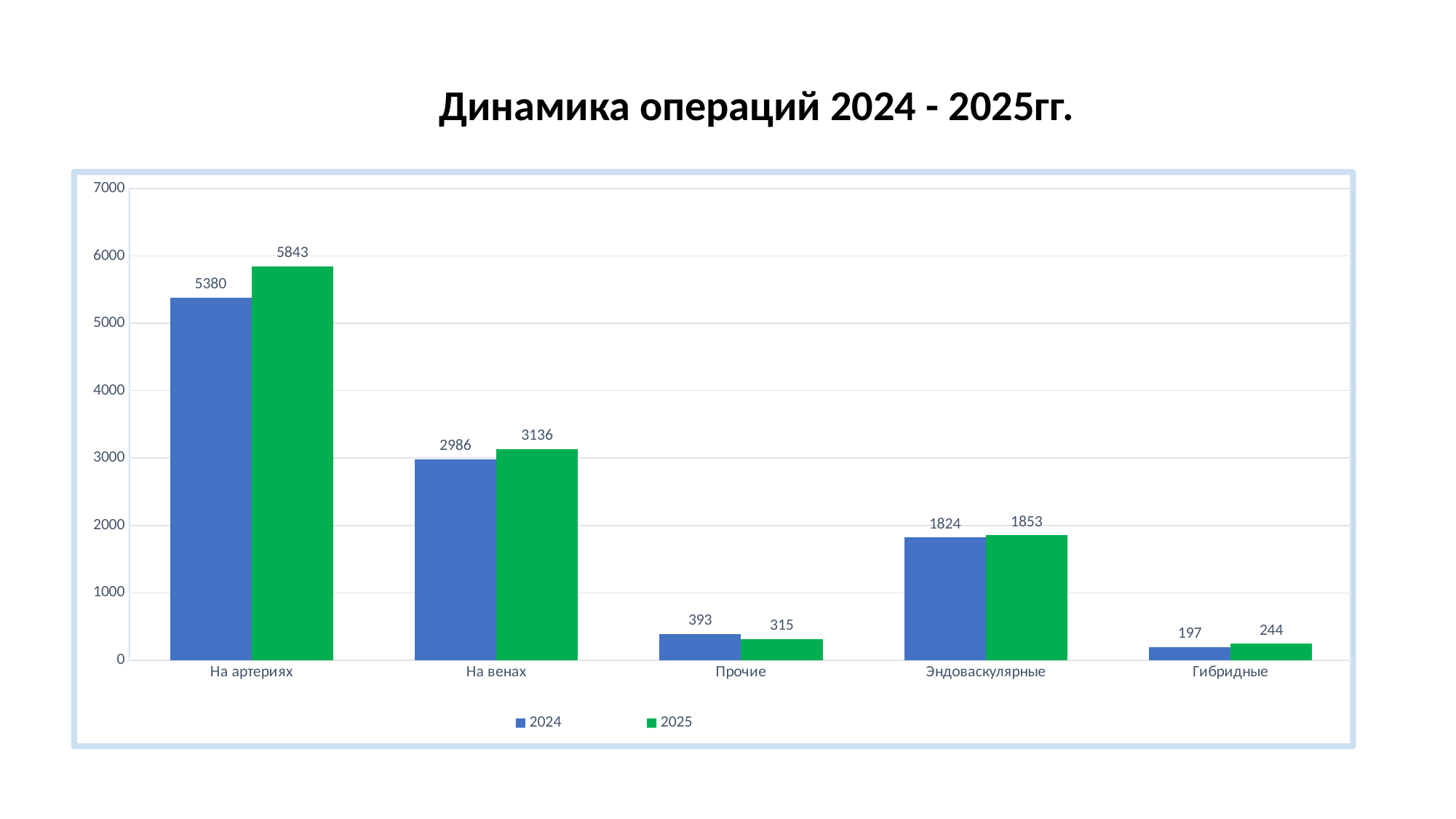
How many series does the legend list? 2 Which category has the highest 2025 value? На артериях What is the 2024 value for На артериях? 5380 For Прочие, which year has the larger value, 2024 or 2025? 2024 What is the 2025 value for Гибридные? 244 What is the title of the chart? Динамика операций 2024 - 2025гг. How many categories are shown on the x axis? 5 What kind of chart is shown on the slide? bar chart Is the 2024 value for На венах greater or less than 3000? less What is the 2025 value for Эндоваскулярные? 1853 Which category has the lowest 2024 value? Гибридные What is the difference between the 2025 and 2024 values for На венах? 150